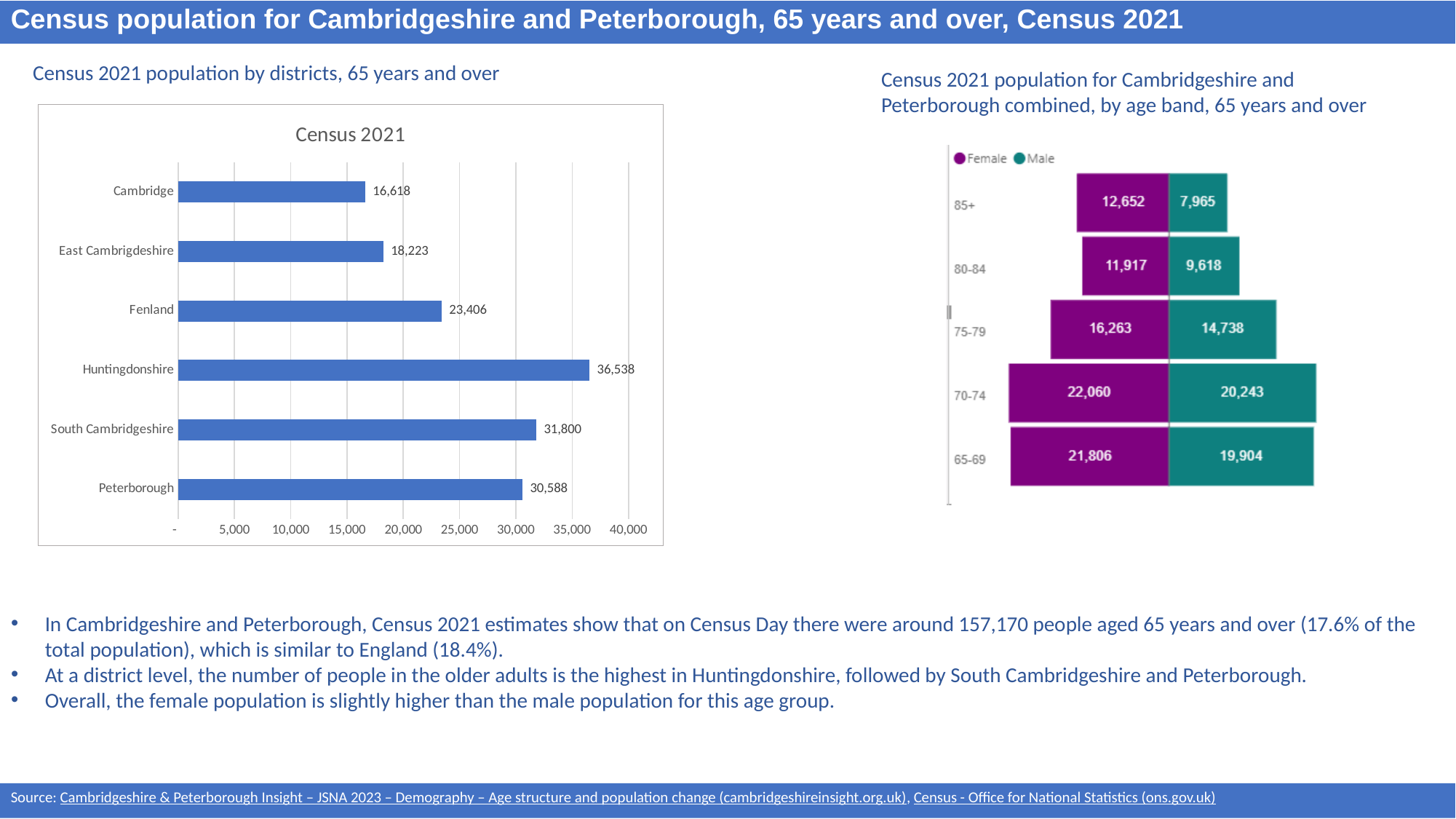
In the right chart (population by age band, 65 years and over), what is the difference between the Female and Male values for the 80-84 age band? 2,299 How many series does the legend of the right chart (population by age band, 65 years and over) list? 2 In the right chart (population by age band, 65 years and over), what is the Male value for the 85+ age band? 7,965 In the right chart (population by age band, 65 years and over), which is larger for the 70-74 age band, Female or Male? Female In the left chart (Census 2021 population by districts, 65 years and over), is the value for East Cambrigdeshire greater or less than 20,000? less In the left chart (Census 2021 population by districts, 65 years and over), which district has the highest value? Huntingdonshire In the left chart (Census 2021 population by districts, 65 years and over), what is the difference between South Cambridgeshire and Peterborough? 1,212 In the left chart (Census 2021 population by districts, 65 years and over), what is the value for Fenland? 23,406 What kind of chart is the left chart (Census 2021 population by districts, 65 years and over)? bar chart In the right chart (population by age band, 65 years and over), what is the Female value for the 75-79 age band? 16,263 In the left chart (Census 2021 population by districts, 65 years and over), how many districts are shown? 6 In the left chart (Census 2021 population by districts, 65 years and over), which district has the lowest value? Cambridge